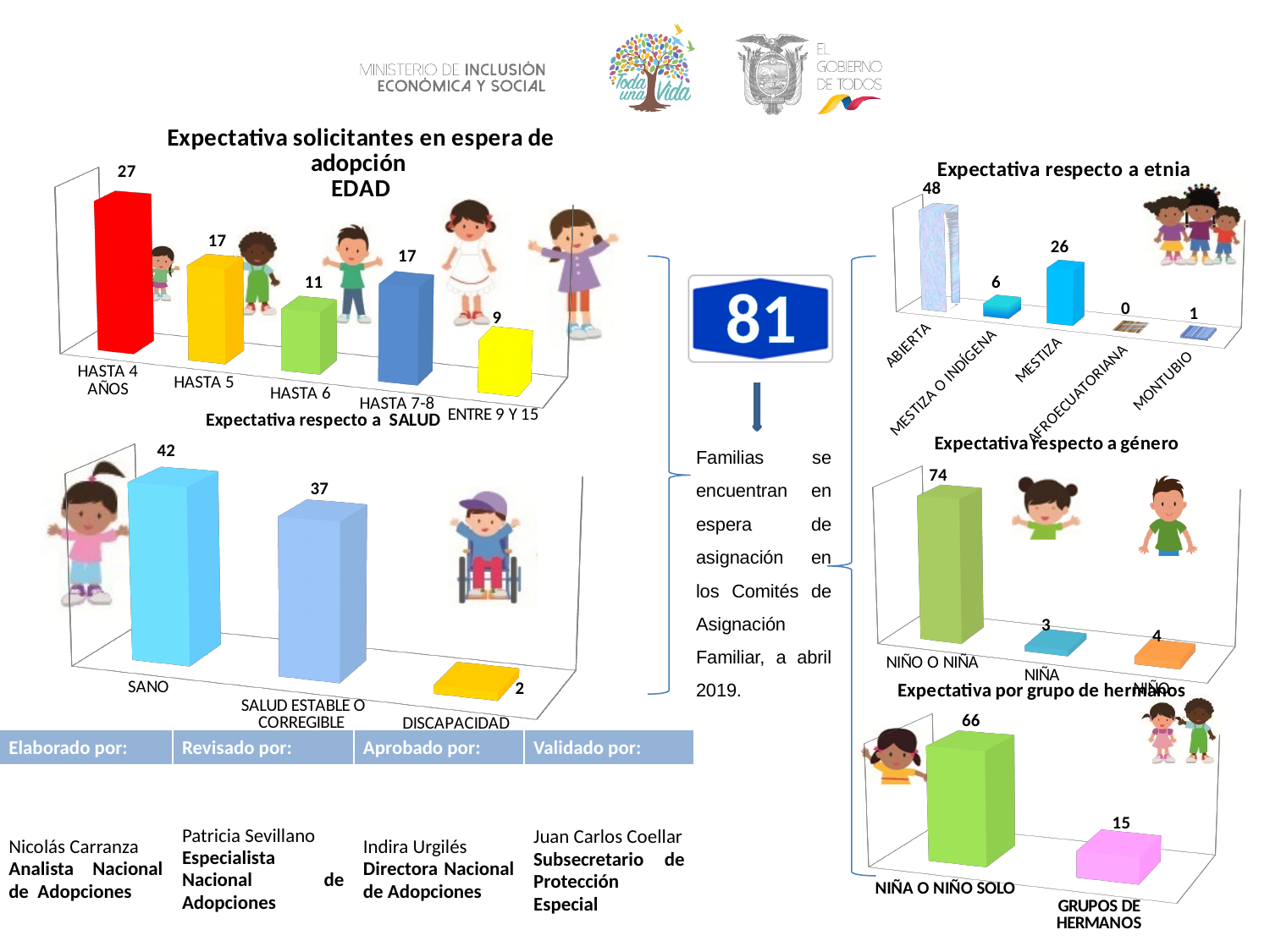
In the 'Expectativa por grupo de hermanos' chart, what is the difference between NIÑA O NIÑO SOLO and GRUPOS DE HERMANOS? 51 What kind of chart is 'Expectativa por grupo de hermanos'? Bar chart In the 'Expectativa respecto a etnia' chart, which is larger, ABIERTA or MESTIZA O INDÍGENA? ABIERTA In the 'Expectativa respecto a SALUD' chart, what is the difference between SANO and DISCAPACIDAD? 40 In the 'Expectativa solicitantes en espera de adopción EDAD' chart, how many categories are shown? 5 In the 'Expectativa respecto a SALUD' chart, what is the value for SALUD ESTABLE O CORREGIBLE? 37 In the 'Expectativa respecto a SALUD' chart, which category has the highest value? SANO In the 'Expectativa solicitantes en espera de adopción EDAD' chart, which category has the lowest value? ENTRE 9 Y 15 In the 'Expectativa respecto a género' chart, what is the value for NIÑO O NIÑA? 74 In the 'Expectativa solicitantes en espera de adopción EDAD' chart, what is the value for HASTA 4 AÑOS? 27 In the 'Expectativa respecto a etnia' chart, which category has the lowest value? AFROECUATORIANA In the 'Expectativa respecto a etnia' chart, what is the value for MESTIZA? 26